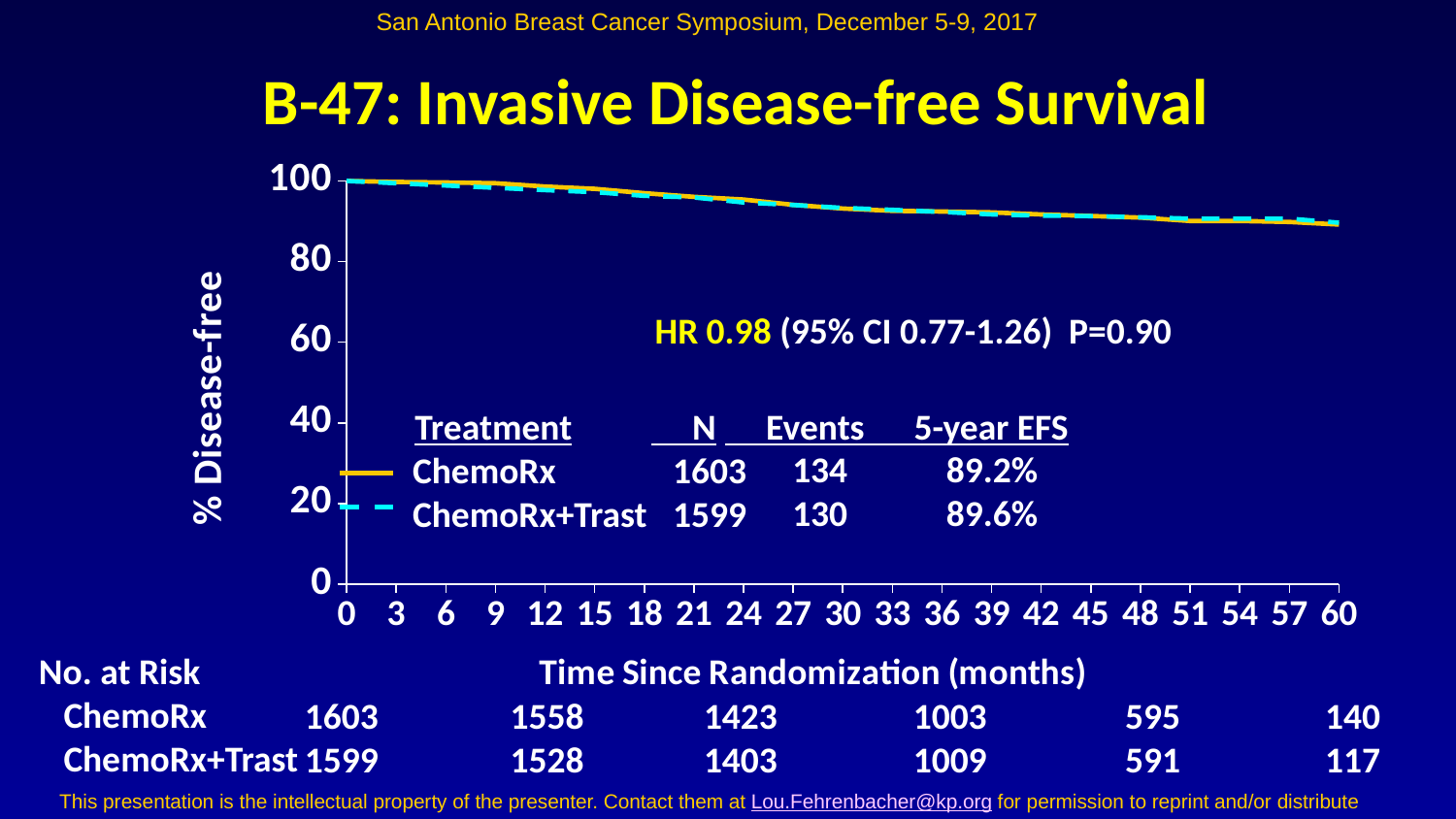
At 60 months, is the % disease-free value for the ChemoRx curve greater or less than 80? greater Do the % disease-free curves rise or fall as time since randomization increases? Fall How many patients in the ChemoRx+Trast group were at risk at 60 months? 117 What is the 5-year EFS for the ChemoRx group? 89.2% What is the difference in the number of events between the ChemoRx and ChemoRx+Trast groups? 4 What is the 5-year EFS for the ChemoRx+Trast group? 89.6% What kind of chart is shown on the slide? Line chart How many treatment groups (series) are plotted on the chart? 2 How many events were recorded in the ChemoRx group? 134 What hazard ratio (HR) is reported on the chart? 0.98 Which group has the higher 5-year EFS, ChemoRx or ChemoRx+Trast? ChemoRx+Trast What is the N for the ChemoRx+Trast group? 1599